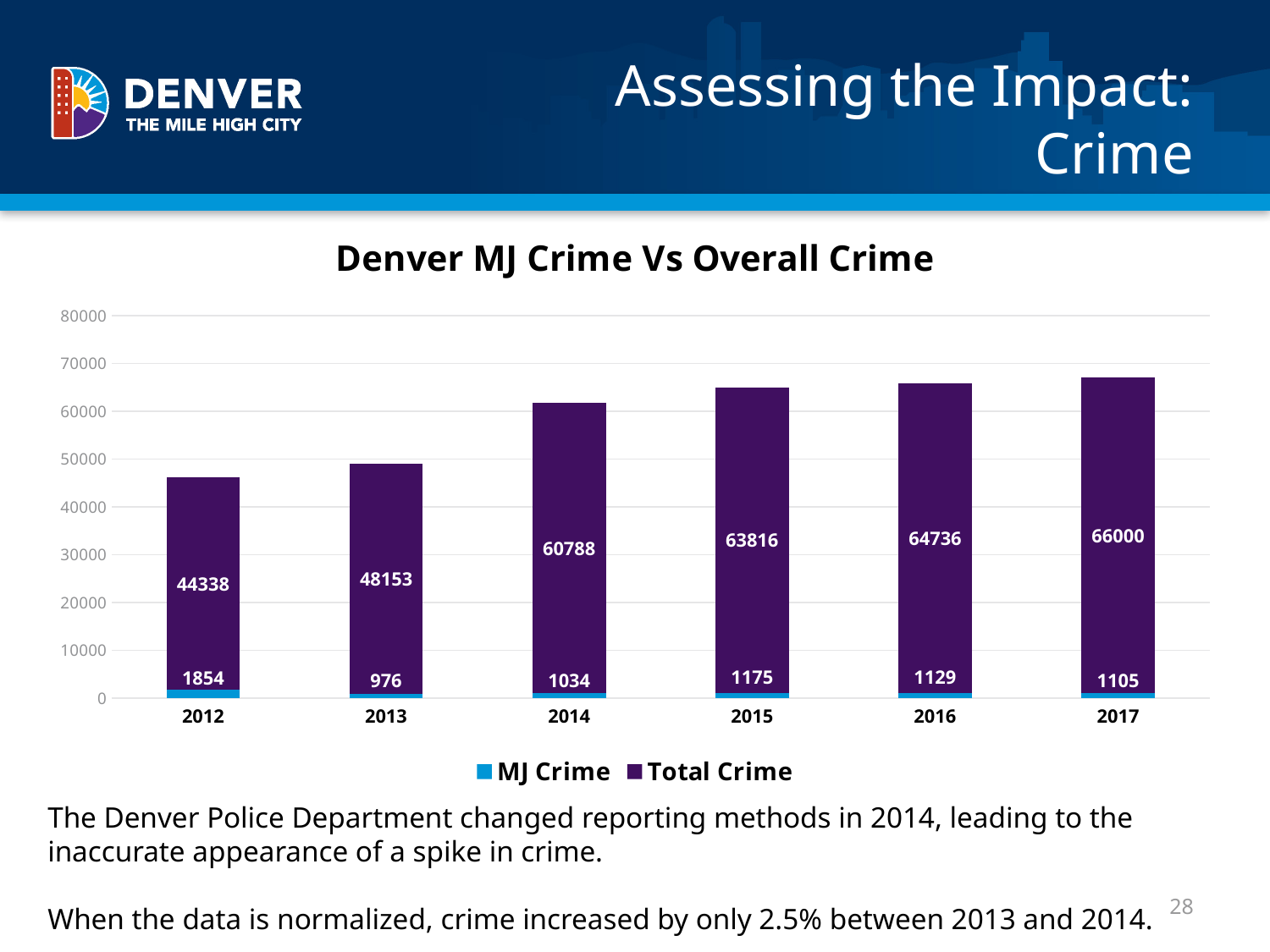
Which year has the highest MJ Crime value? 2012 Which is larger, the MJ Crime value for 2016 or for 2017? 2016 What is the MJ Crime value for 2015? 1175 How many years are shown on the x axis? 6 Does the Total Crime value rise or fall from 2012 to 2017? Rise What is the difference between the Total Crime values for 2017 and 2012? 21662 Which year has the lowest Total Crime value? 2012 What is the total of the stacked bar for 2013 (MJ Crime plus Total Crime)? 49129 What is the Total Crime value for 2014? 60788 How many series does the legend list? 2 What kind of chart is shown on the slide? Stacked bar chart Which year has the lowest MJ Crime value? 2013